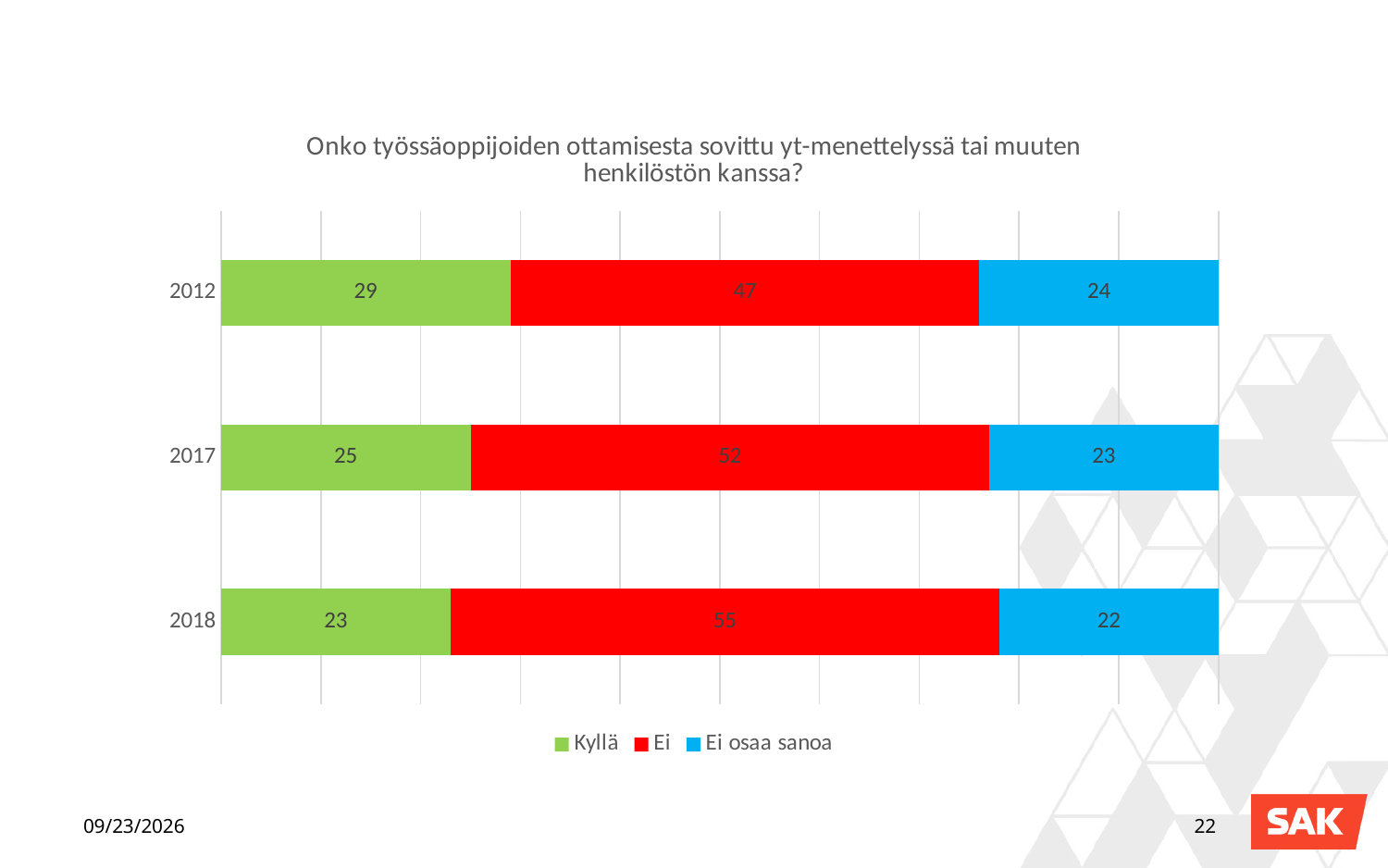
What is the value for "Ei" in 2017? 52 How many series does the legend list? 3 In which year is the "Kyllä" value lowest? 2018 Which is larger: "Kyllä" in 2012 or "Kyllä" in 2017? Kyllä in 2012 What is the difference between the "Ei" values for 2018 and 2012? 8 In which year is the "Ei" value highest? 2018 What is the value for "Ei osaa sanoa" in 2018? 22 Which colour represents "Ei osaa sanoa" in the chart? Blue What is the value for "Kyllä" in 2012? 29 How many years are shown on the chart? 3 What kind of chart is shown on the slide? Stacked bar chart What is the total of the stacked bar for 2017? 100